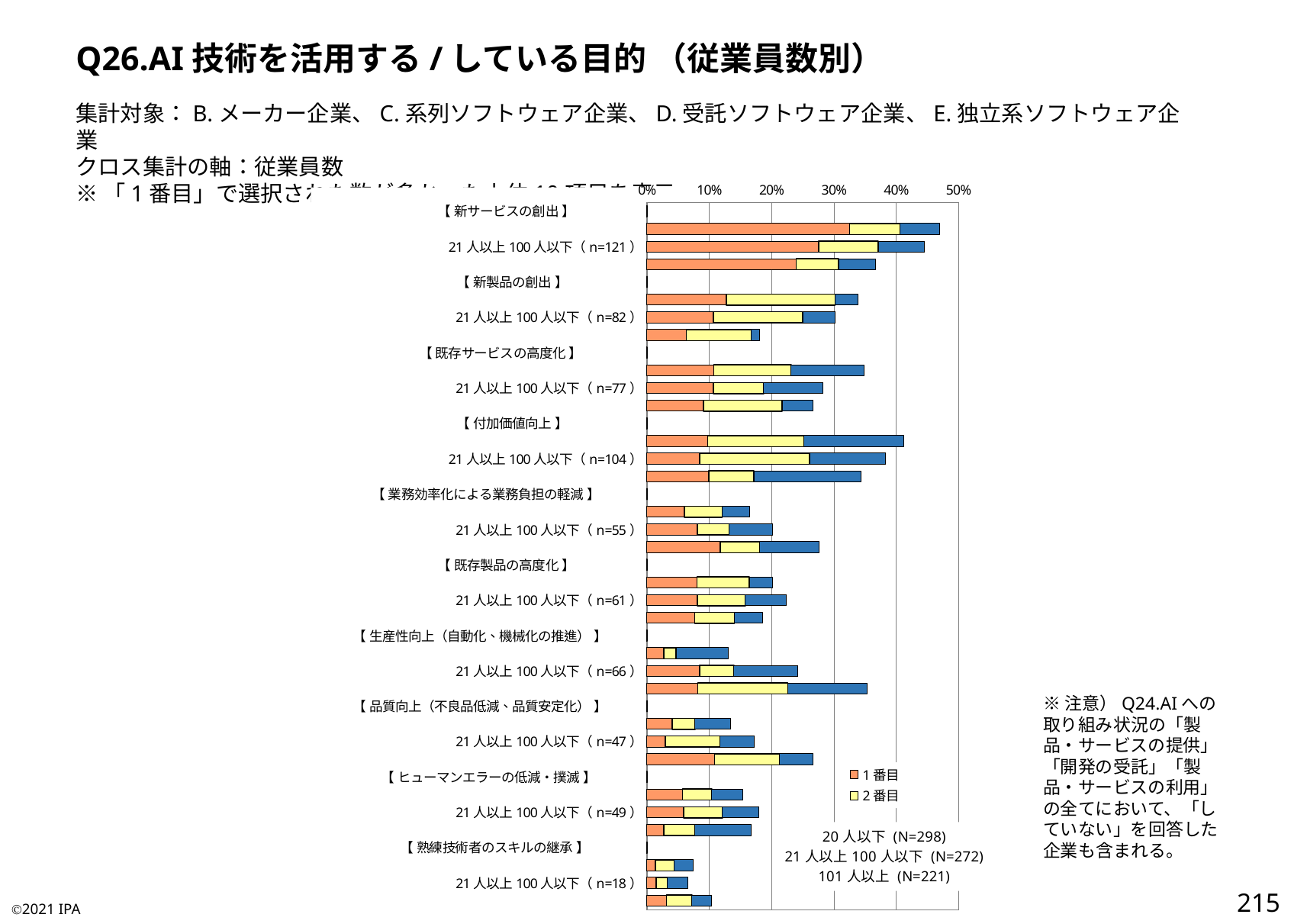
Is the total of the bottom stacked bar under 【新製品の創出】 greater or less than 20%? less How many purpose categories (the labels in 【 】 brackets) are listed on the chart? 10 According to the note on the chart, what is N for 101人以上? 221 What colour represents the series 1番目 in the legend? Orange Which purpose category has the shortest stacked bars on the chart? 【熟練技術者のスキルの継承】 What is the highest value shown on the horizontal axis of the chart? 50% Which is larger: the top stacked bar under 【新サービスの創出】 or the top stacked bar under 【品質向上（不良品低減、品質安定化）】? 【新サービスの創出】 Is the total of the top stacked bar under 【熟練技術者のスキルの継承】 greater or less than 10%? less Is the total of the bottom stacked bar under 【生産性向上（自動化、機械化の推進）】 greater or less than 30%? greater Which purpose category has the longest stacked bar on the chart? 【新サービスの創出】 What kind of chart is shown on the slide? Stacked horizontal bar chart